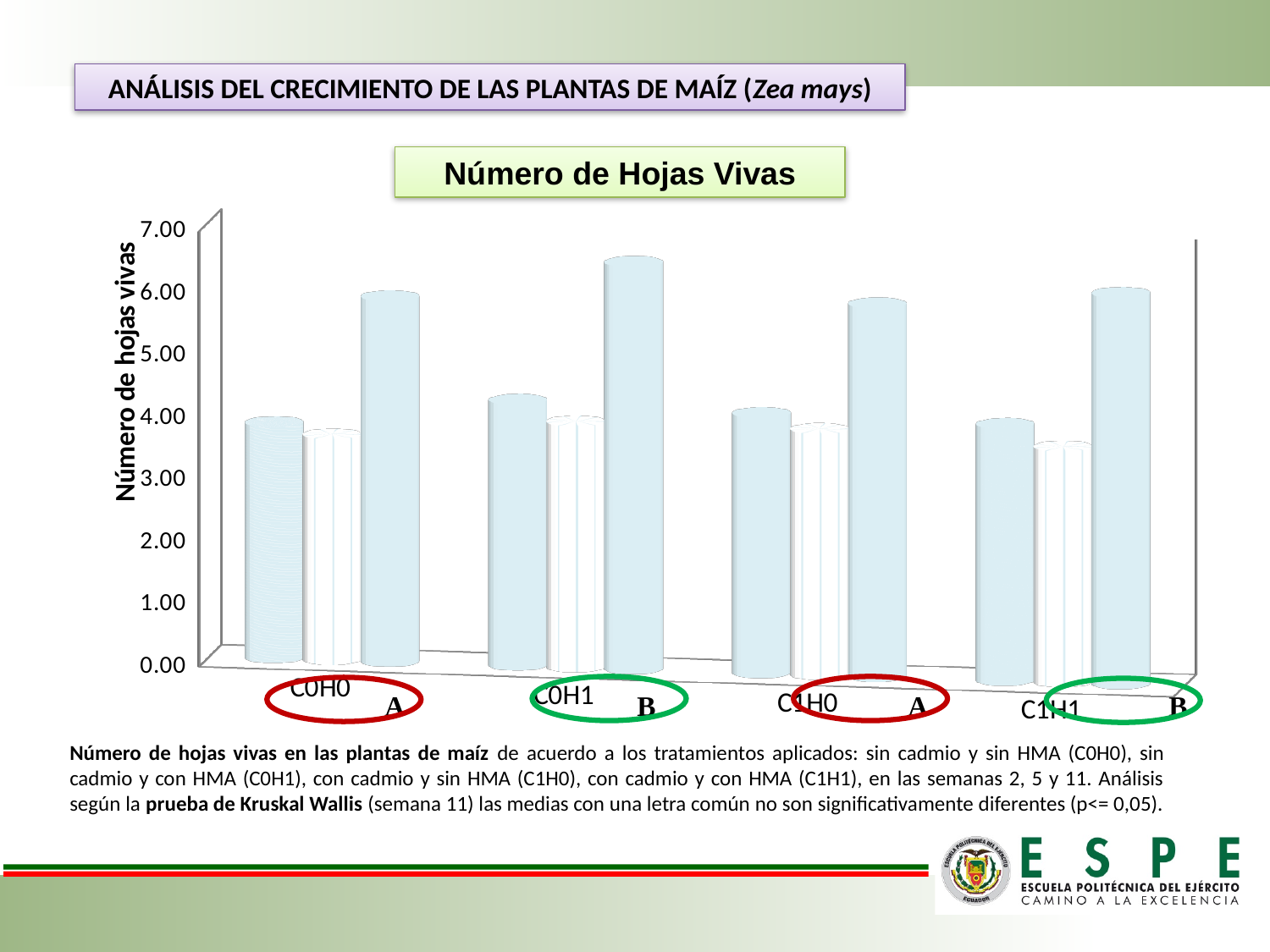
What is the label of the vertical axis? Número de hojas vivas How many bars are plotted for each treatment category? 3 Is the value of the tallest bar for C0H1 greater or less than 5.00? greater How many treatment categories are shown on the x axis of the chart? 4 What kind of chart is shown on the slide? Bar chart Is the value of the third bar for C1H0 greater or less than 5.00? greater Is the value of the second bar for C1H1 greater or less than 4.00? less Within the C0H0 category, which is larger: the first bar or the third bar? The third bar Which treatment category contains the tallest bar in the chart? C0H1 What is the highest value shown on the vertical axis? 7.00 What is the title of the chart? Número de Hojas Vivas